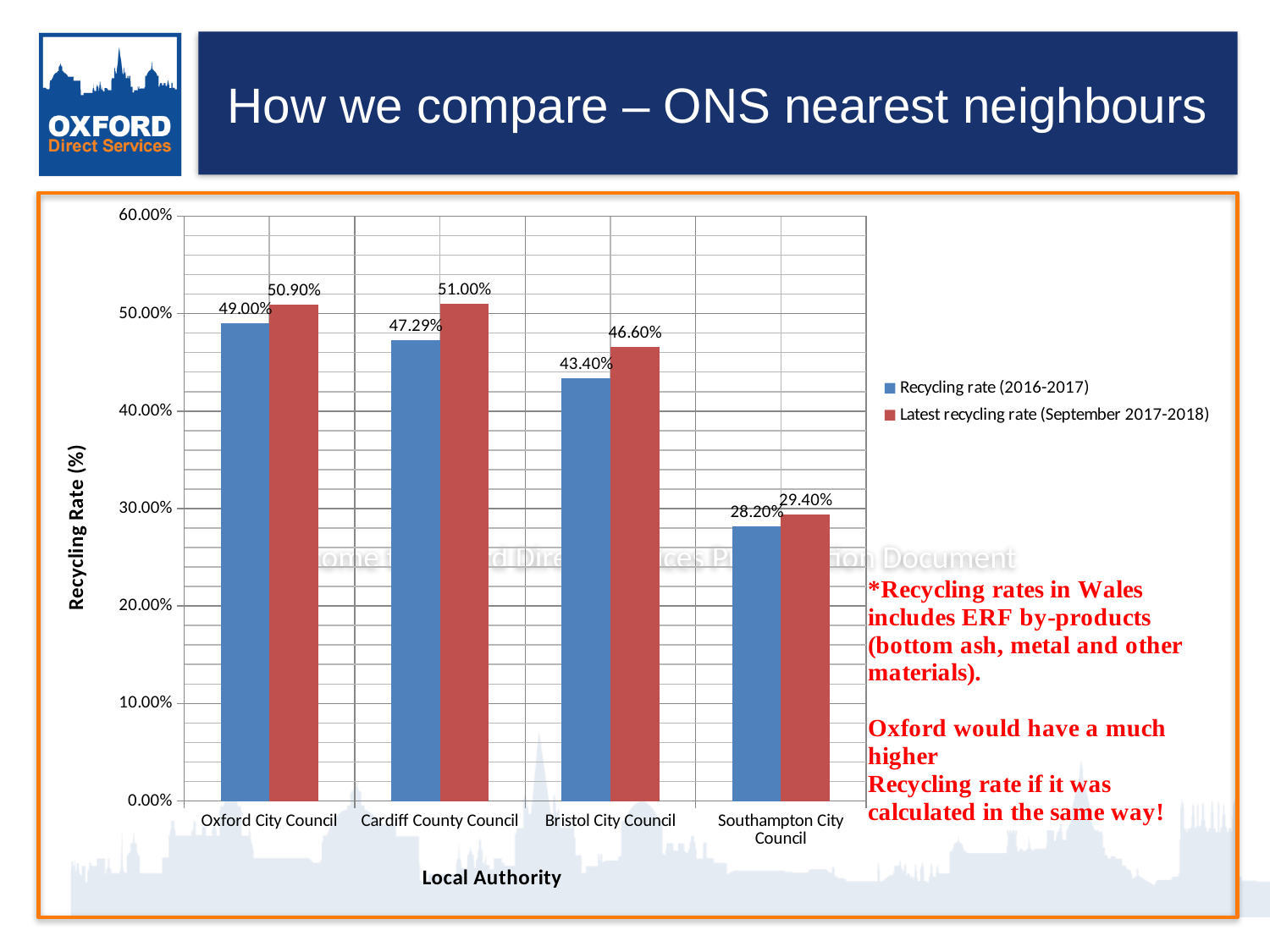
Is the Latest recycling rate (September 2017-2018) for Southampton City Council greater or less than 30.00%? less Which local authority has the lowest Recycling rate (2016-2017)? Southampton City Council What is the difference between the Latest recycling rate (September 2017-2018) and the Recycling rate (2016-2017) for Bristol City Council? 3.20% Which is larger: the Recycling rate (2016-2017) for Oxford City Council or for Cardiff County Council? Oxford City Council What kind of chart is shown on the slide? Bar chart How many local authorities are shown on the x axis? 4 What is the label of the y axis? Recycling Rate (%) What is the Recycling rate (2016-2017) for Oxford City Council? 49.00% How many series does the legend list? 2 What is the Recycling rate (2016-2017) for Southampton City Council? 28.20% What is the Latest recycling rate (September 2017-2018) for Cardiff County Council? 51.00% Which local authority has the highest Latest recycling rate (September 2017-2018)? Cardiff County Council